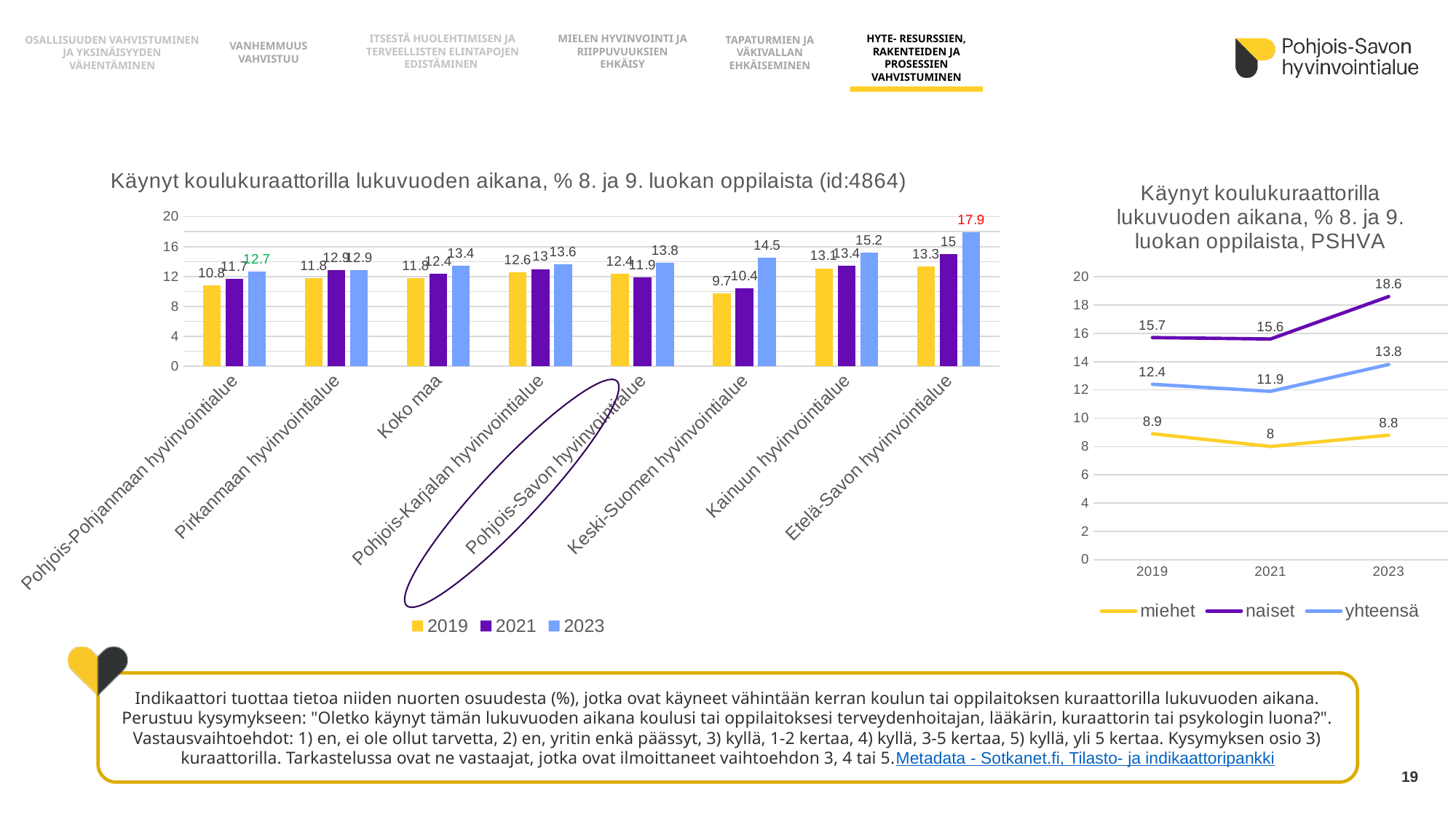
In the left bar chart, what is the difference between the 2023 and 2021 values for Keski-Suomen hyvinvointialue? 4.1 In the left bar chart, what is the 2023 value for Etelä-Savon hyvinvointialue? 17.9 What kind of chart is the chart on the right of the slide? Line chart In the left bar chart, which category has the lowest 2019 value? Keski-Suomen hyvinvointialue In the left bar chart, which category has the highest 2023 value? Etelä-Savon hyvinvointialue In the right line chart, what is the value for naiset in 2023? 18.6 How many series does the legend of the left bar chart list? 3 How many categories are shown on the x axis of the left bar chart? 8 In the right line chart, which series has the lowest value in 2019? miehet In the right line chart, what is the difference between naiset and miehet in 2021? 7.6 In the left bar chart, what is the 2019 value for Keski-Suomen hyvinvointialue? 9.7 In the left bar chart, which is larger for Pohjois-Savon hyvinvointialue: the 2019 value or the 2021 value? 2019